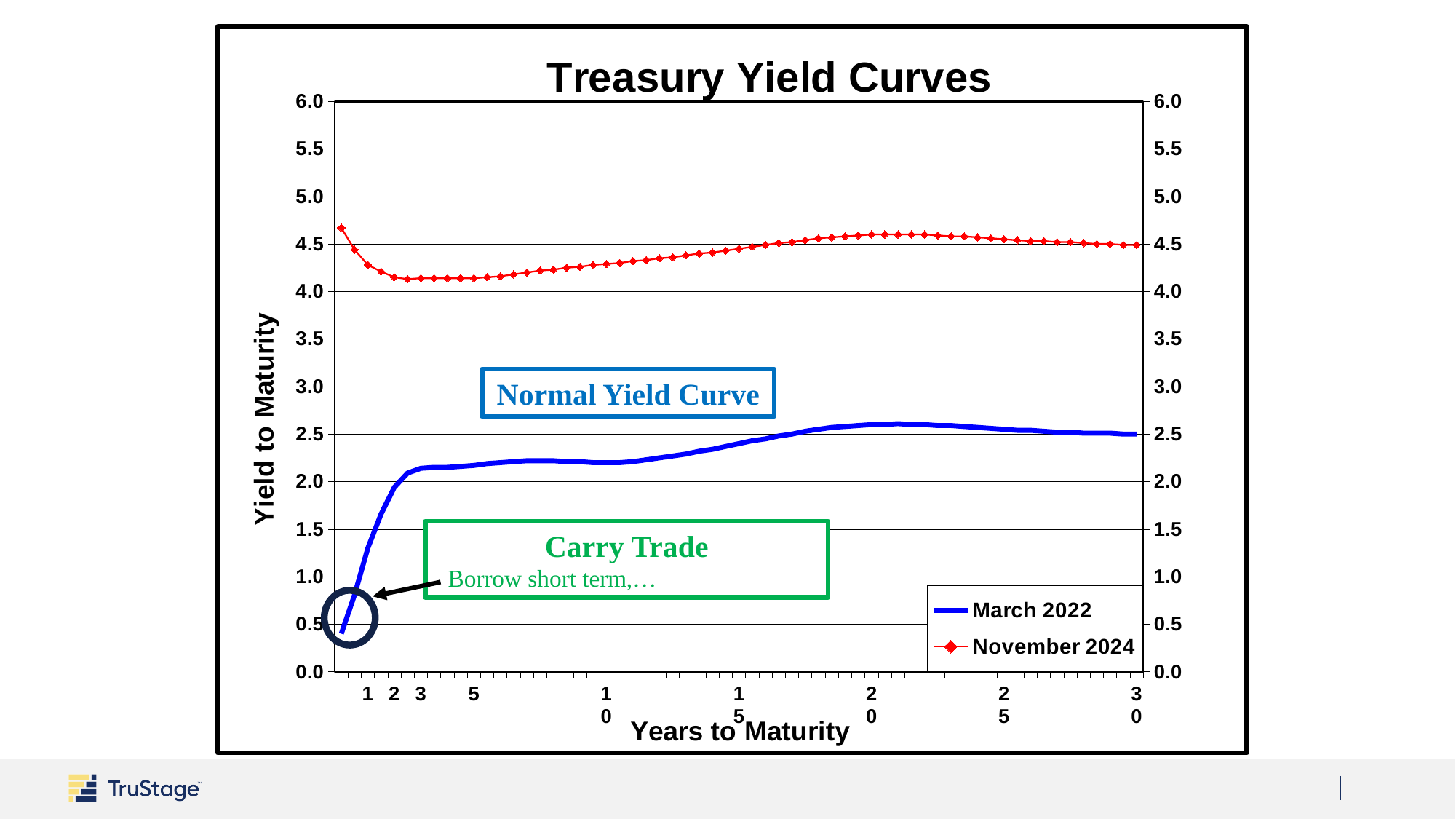
At 20 years to maturity, is the yield for March 2022 greater or less than 2.0? greater At 30 years to maturity, is the yield for November 2024 greater or less than 4.0? greater Does the March 2022 yield rise or fall as maturity increases from 1 year to 5 years? rise What kind of chart is shown on the slide? line chart At 5 years to maturity, is the yield for November 2024 greater or less than 4.0? greater At 10 years to maturity, which series has the higher yield, March 2022 or November 2024? November 2024 What is the title of the chart? Treasury Yield Curves Which series is drawn in red with diamond markers? November 2024 Does the November 2024 yield rise or fall as maturity increases from 1 year to 3 years? fall How many series does the legend list? 2